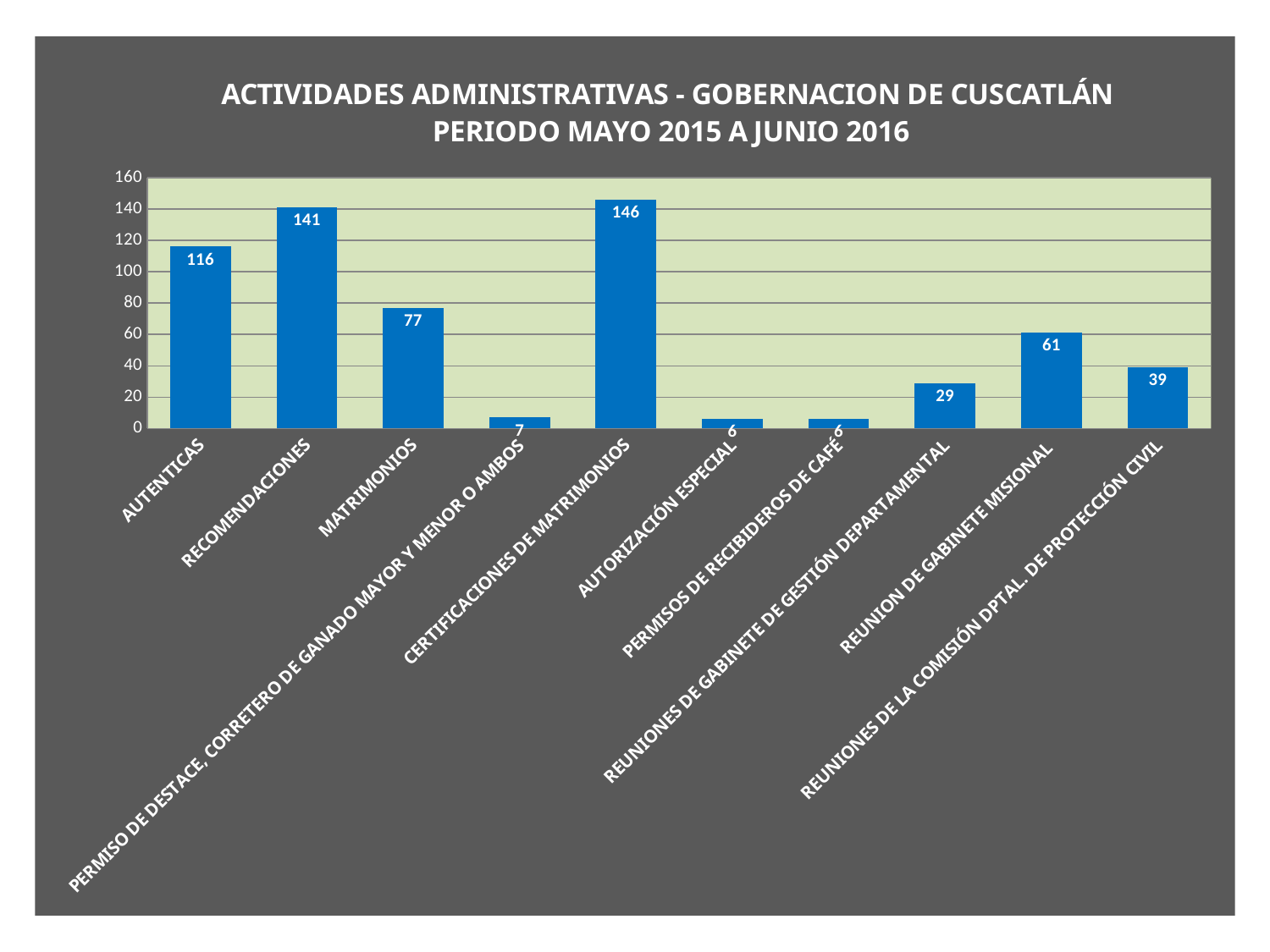
What is the value for AUTENTICAS? 116 What is the value for MATRIMONIOS? 77 What is the value for RECOMENDACIONES? 141 What is the value for REUNIONES DE LA COMISIÓN DPTAL. DE PROTECCIÓN CIVIL? 39 What is the difference between the values for AUTENTICAS and MATRIMONIOS? 39 Which category has the highest value? CERTIFICACIONES DE MATRIMONIOS What is the value for REUNION DE GABINETE MISIONAL? 61 Which is larger, the value for REUNION DE GABINETE MISIONAL or the value for REUNIONES DE GABINETE DE GESTIÓN DEPARTAMENTAL? REUNION DE GABINETE MISIONAL How many categories are shown on the x axis? 10 What is the difference between the values for CERTIFICACIONES DE MATRIMONIOS and RECOMENDACIONES? 5 What period does the chart title say the data covers? MAYO 2015 A JUNIO 2016 What kind of chart is shown on the slide? Bar chart